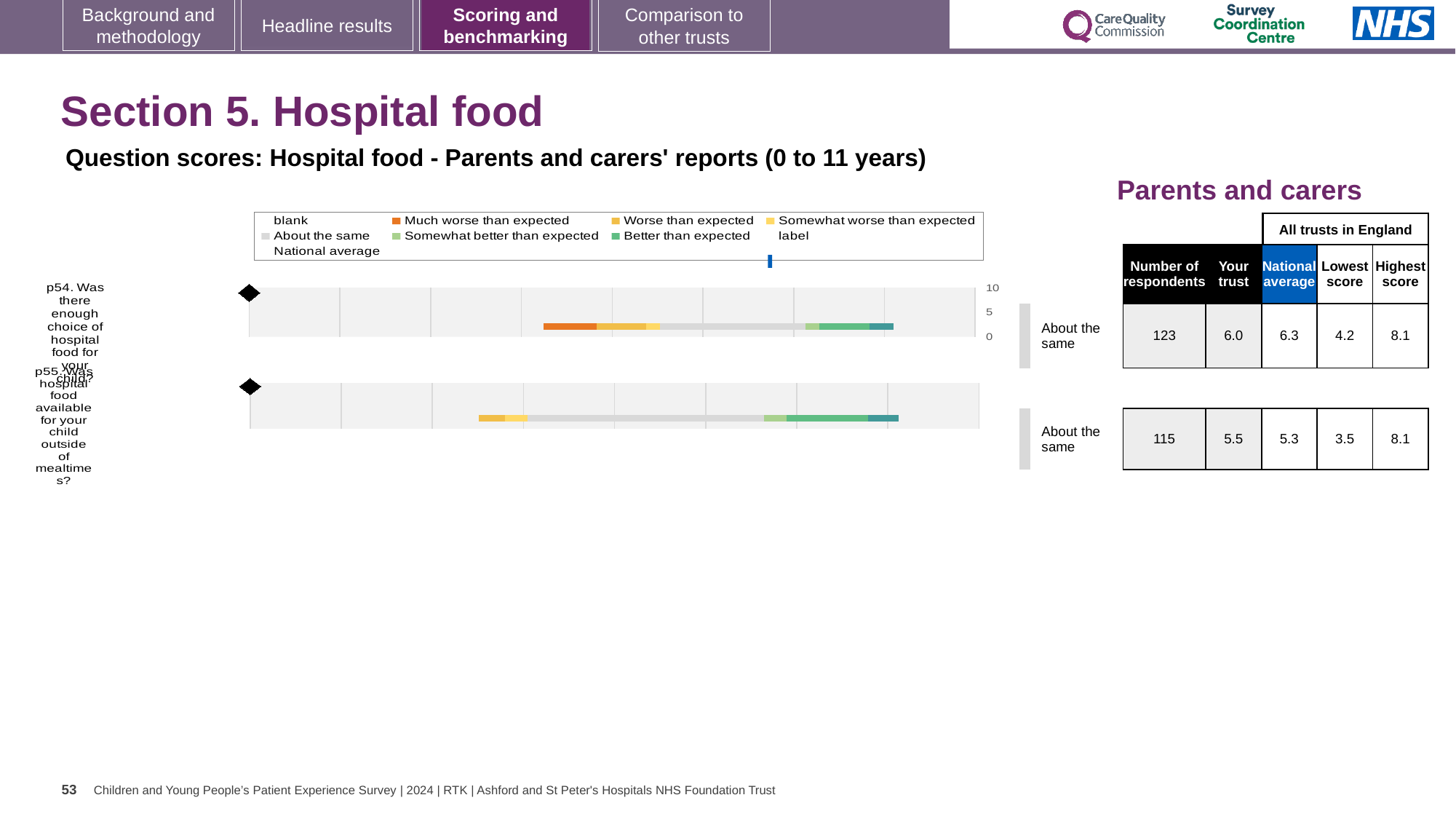
What is the difference between the highest score and the lowest score for p54 (enough choice of hospital food)? 3.9 What benchmark category is shown for p54 (enough choice of hospital food)? About the same How many survey questions are plotted in the chart? 2 What kind of chart is used to show the question scores? bar chart What is the lowest score among all trusts in England for p55 (hospital food available outside of mealtimes)? 3.5 Which question has the higher 'Your trust' score, p54 or p55? p54 What is the 'Your trust' score for p54 (enough choice of hospital food)? 6.0 What is the highest value shown on the chart's score axis? 10 How many respondents are listed for p54 (enough choice of hospital food)? 123 What is the 'Your trust' score for p55 (hospital food available outside of mealtimes)? 5.5 What is the national average score for p54 (enough choice of hospital food)? 6.3 What colour does the legend use for 'Much worse than expected'? orange